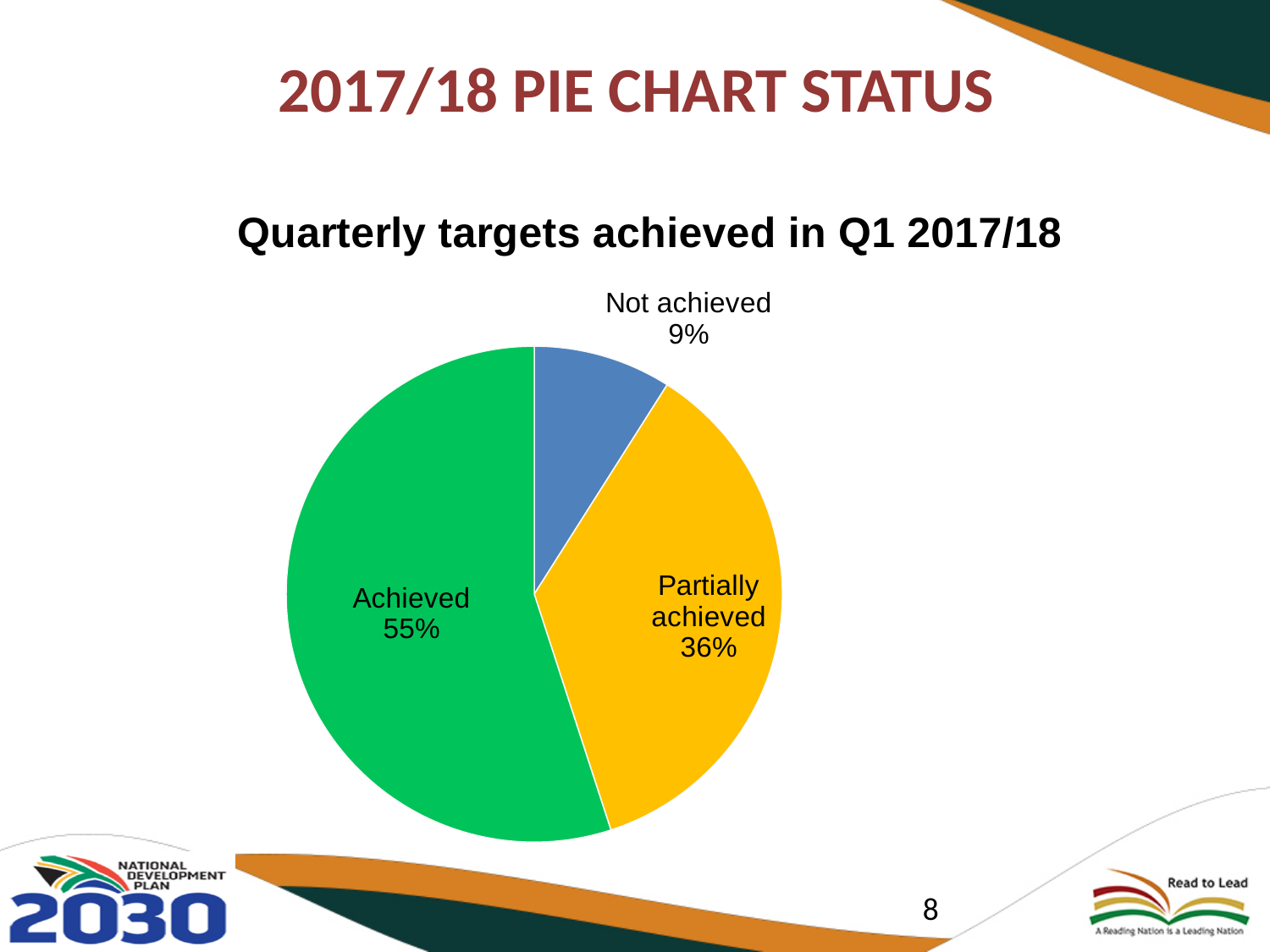
Which category has the largest share of the pie? Achieved What colour is the Achieved slice? Green Which category has the smallest share of the pie? Not achieved What percentage of quarterly targets were achieved? 55% What is the difference in percentage points between Achieved and Partially achieved? 19 What percentage of quarterly targets were partially achieved? 36% What kind of chart is shown on the slide? Pie chart What percentage of quarterly targets were not achieved? 9% What is the chart's title? Quarterly targets achieved in Q1 2017/18 How many slices does the pie chart have? 3 Which is larger, the share for Partially achieved or the share for Not achieved? Partially achieved What is the difference in percentage points between Partially achieved and Not achieved? 27